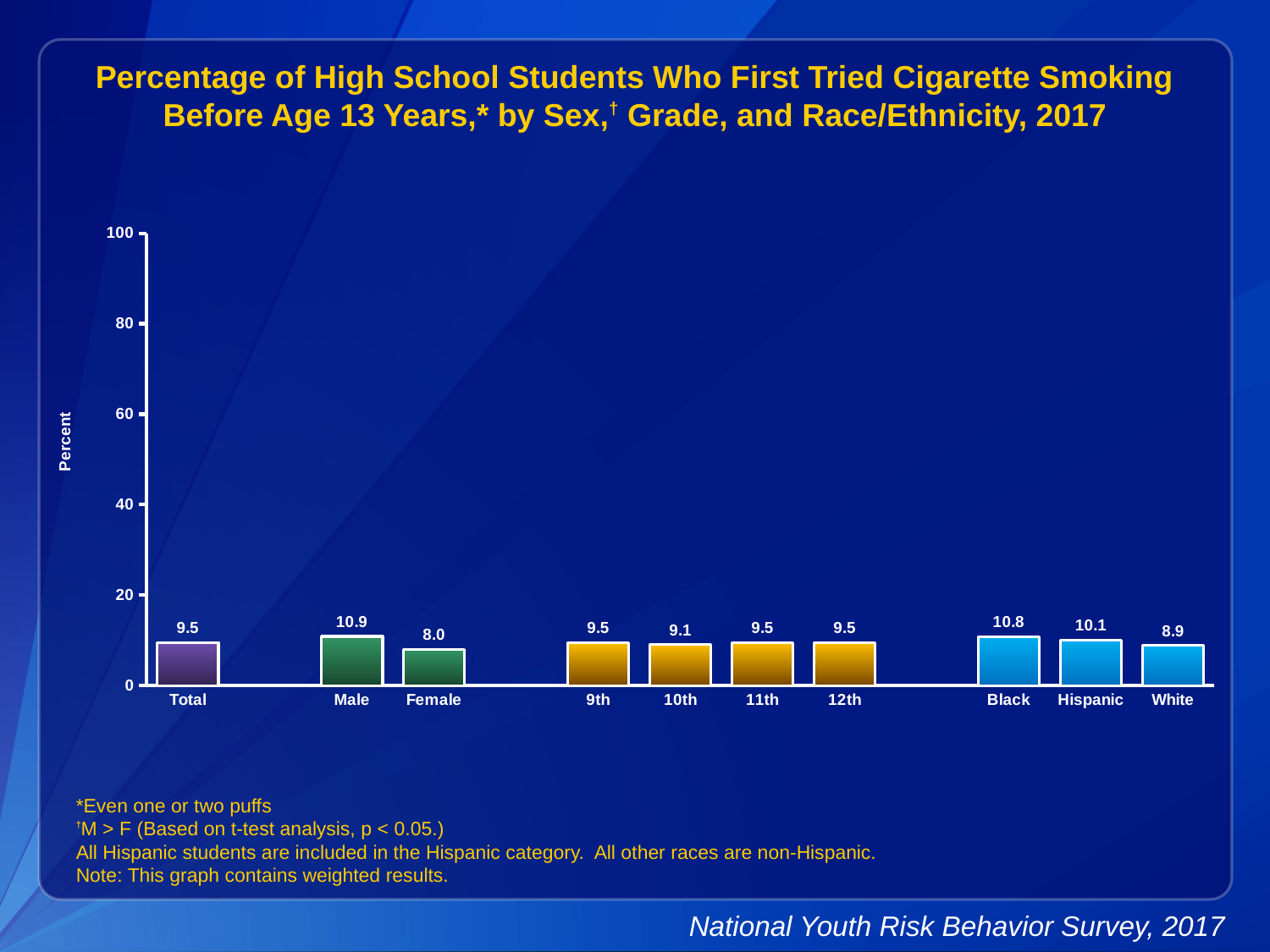
How many categories are shown on the x axis? 10 What is the value for Male? 10.9 Is the value for 12th grade greater or less than 20? less Which is larger, the value for Black or the value for White? Black What is the difference between the Male and Female values? 2.9 Which category has the lowest value? Female What is the value for Total? 9.5 What kind of chart is this? bar chart What is the value for Hispanic? 10.1 Which category has the highest value? Male What is the value for Female? 8.0 What is the value for 10th grade? 9.1